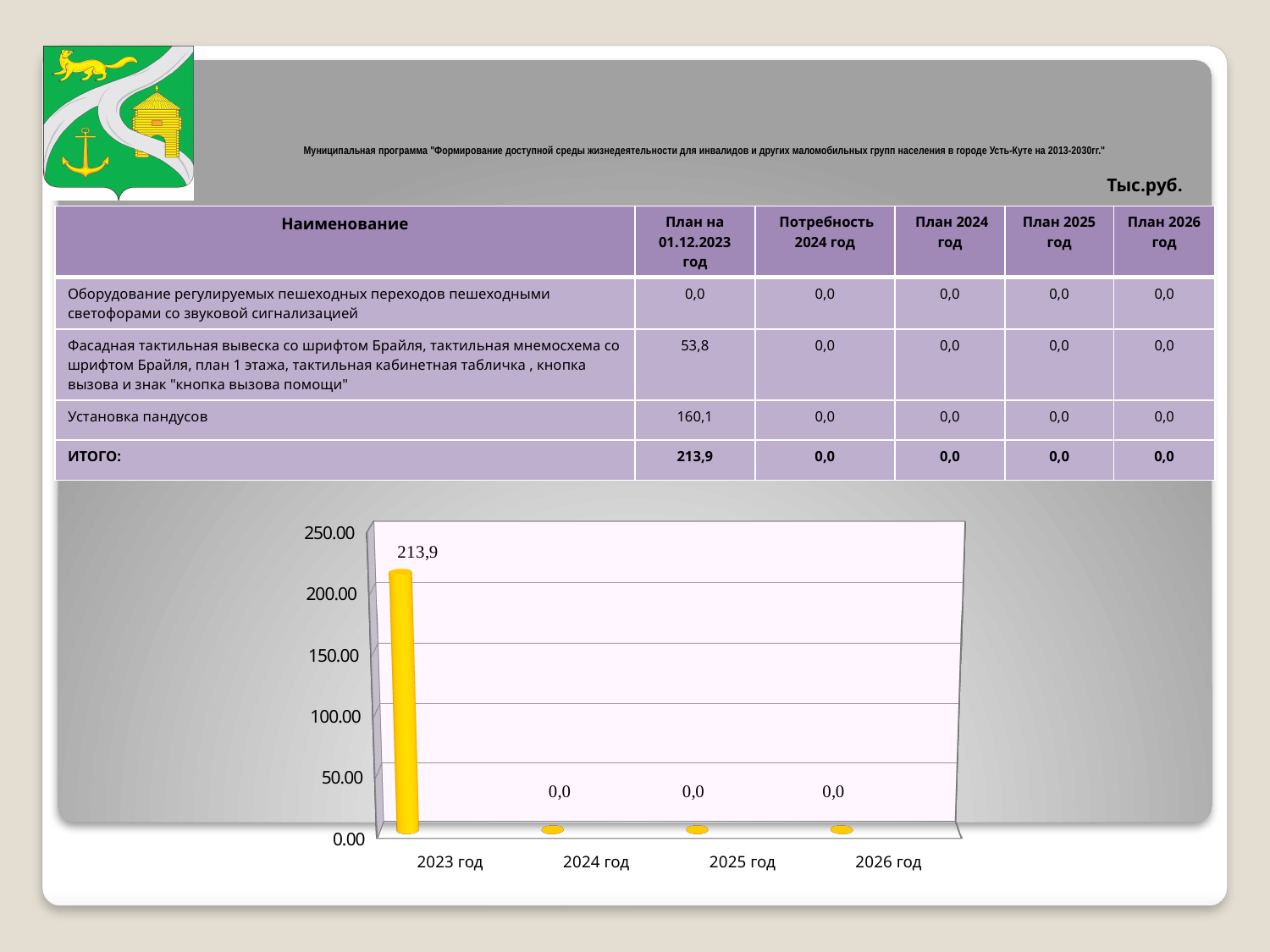
What is the value for 2026 год in the chart? 0,0 What is the difference between the values for 2023 год and 2025 год? 213,9 Which year has the highest value in the chart? 2023 год What is the value for 2024 год in the chart? 0,0 What kind of chart is shown on the slide? bar chart Is the value for 2023 год greater or less than 200.00? greater Do the values rise or fall from 2023 год to 2024 год? fall Which is larger, the value for 2023 год or the value for 2024 год? 2023 год What is the highest tick value shown on the vertical axis of the chart? 250.00 How many categories are shown on the x axis of the chart? 4 What is the value for 2023 год in the chart? 213,9 What colour are the bars in the chart? yellow